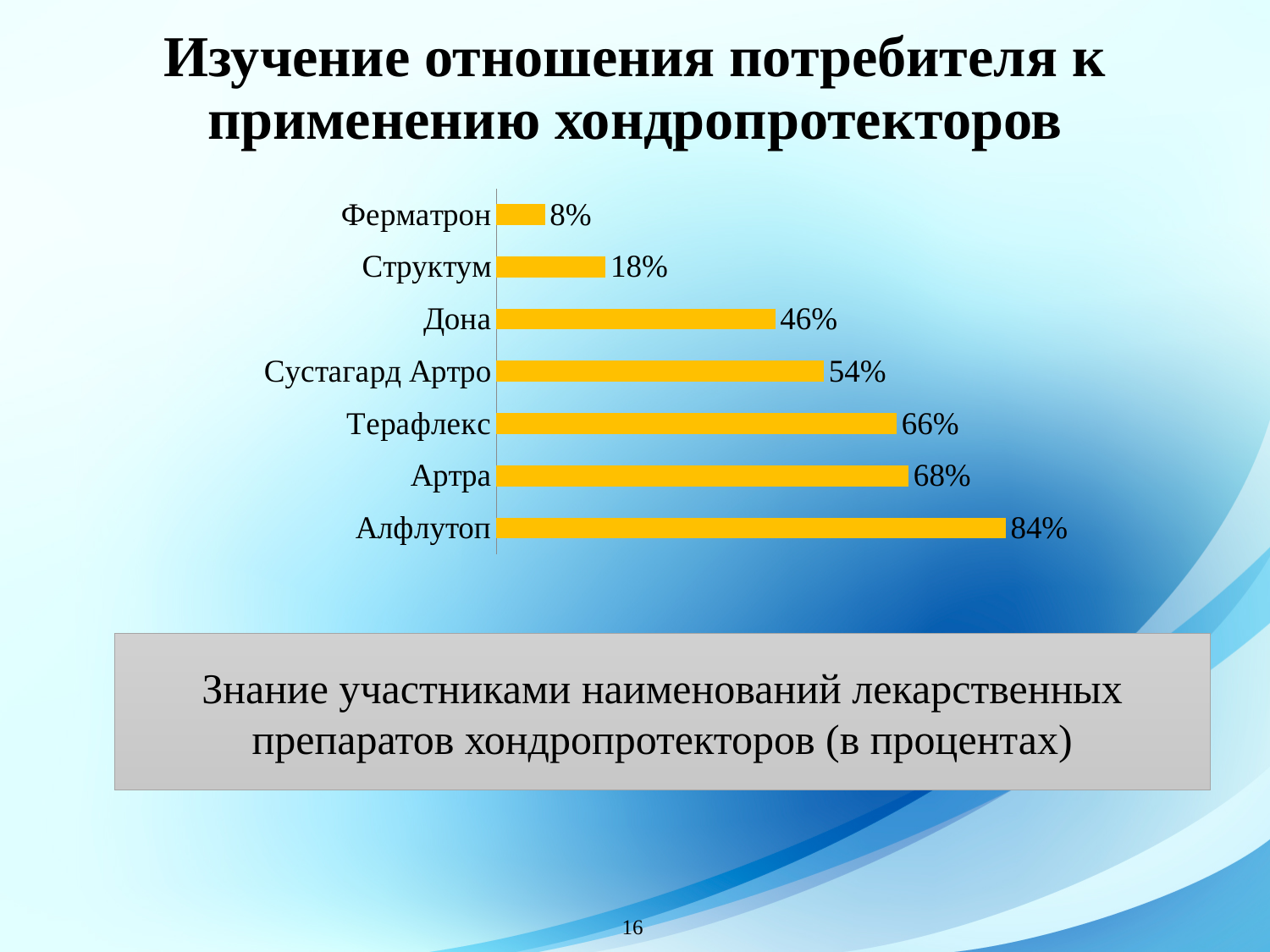
Which drug has the highest value? Алфлутоп What is the value for Сустагард Артро? 54% How many drugs are shown in the chart? 7 Which drug has the lowest value? Ферматрон What is the difference between the values for Алфлутоп and Структум? 66% What colour are the bars in the chart? Yellow What is the value for Дона? 46% What is the value for Алфлутоп? 84% What is the value for Ферматрон? 8% What is the difference between the values for Артра and Терафлекс? 2% Which is larger, the value for Дона or the value for Сустагард Артро? Сустагард Артро What kind of chart is shown on the slide? Bar chart